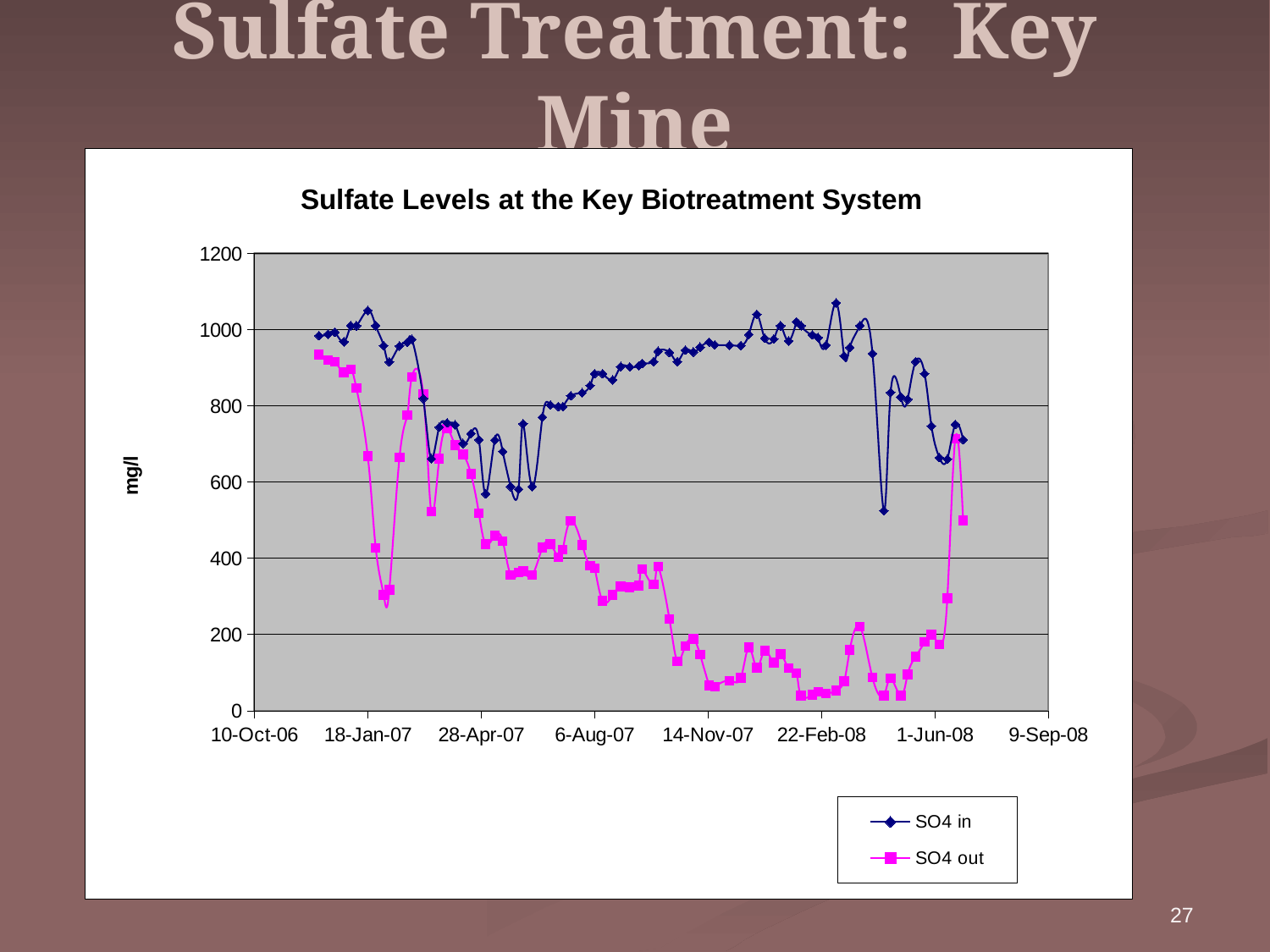
Is the value for SO4 in around 22-Feb-08 greater or less than 800? greater Around 14-Nov-07, which series has the larger value, SO4 in or SO4 out? SO4 in Is the value for SO4 out around 22-Feb-08 greater or less than 200? less Does the SO4 out series generally rise or fall between 10-Oct-06 and 22-Feb-08? fall Is the value for SO4 in around 14-Nov-07 greater or less than 800? greater What kind of chart is shown on the slide? line chart What is the title of the chart? Sulfate Levels at the Key Biotreatment System What is the label on the vertical axis? mg/l How many series does the legend list? 2 Does the SO4 in series generally rise or fall between 28-Apr-07 and 14-Nov-07? rise Which series stays higher across the whole chart, SO4 in or SO4 out? SO4 in